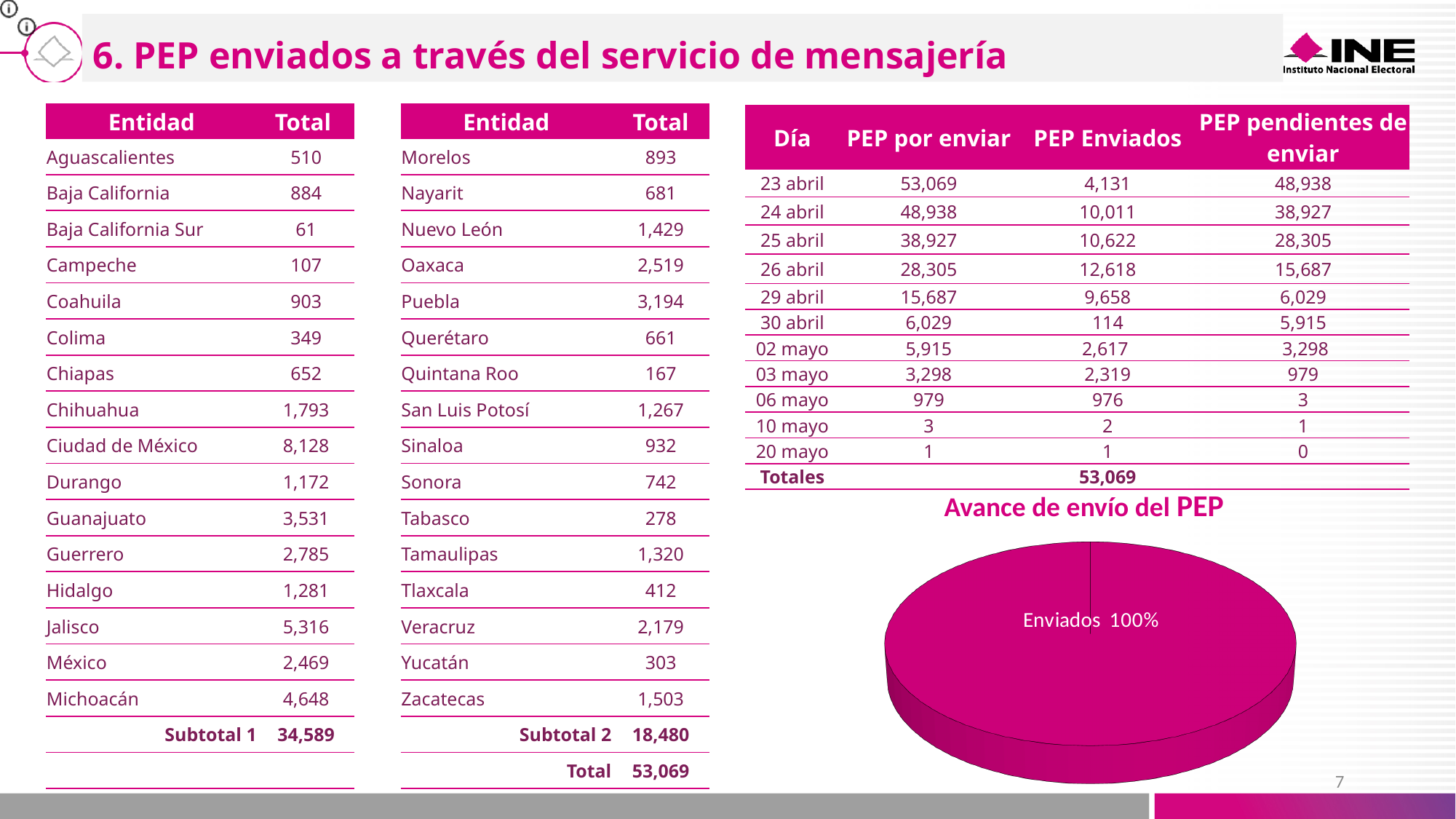
How many slices does the pie chart "Avance de envío del PEP" contain? 1 What is the title of the pie chart on the slide? Avance de envío del PEP Is the share shown for "Enviados" in the pie chart greater or less than 50%? greater In the pie chart "Avance de envío del PEP", what share does the "Enviados" slice represent? 100% What colour is the slice in the pie chart "Avance de envío del PEP"? magenta What kind of chart is shown under the title "Avance de envío del PEP"? pie chart What is the label of the only slice in the pie chart "Avance de envío del PEP"? Enviados